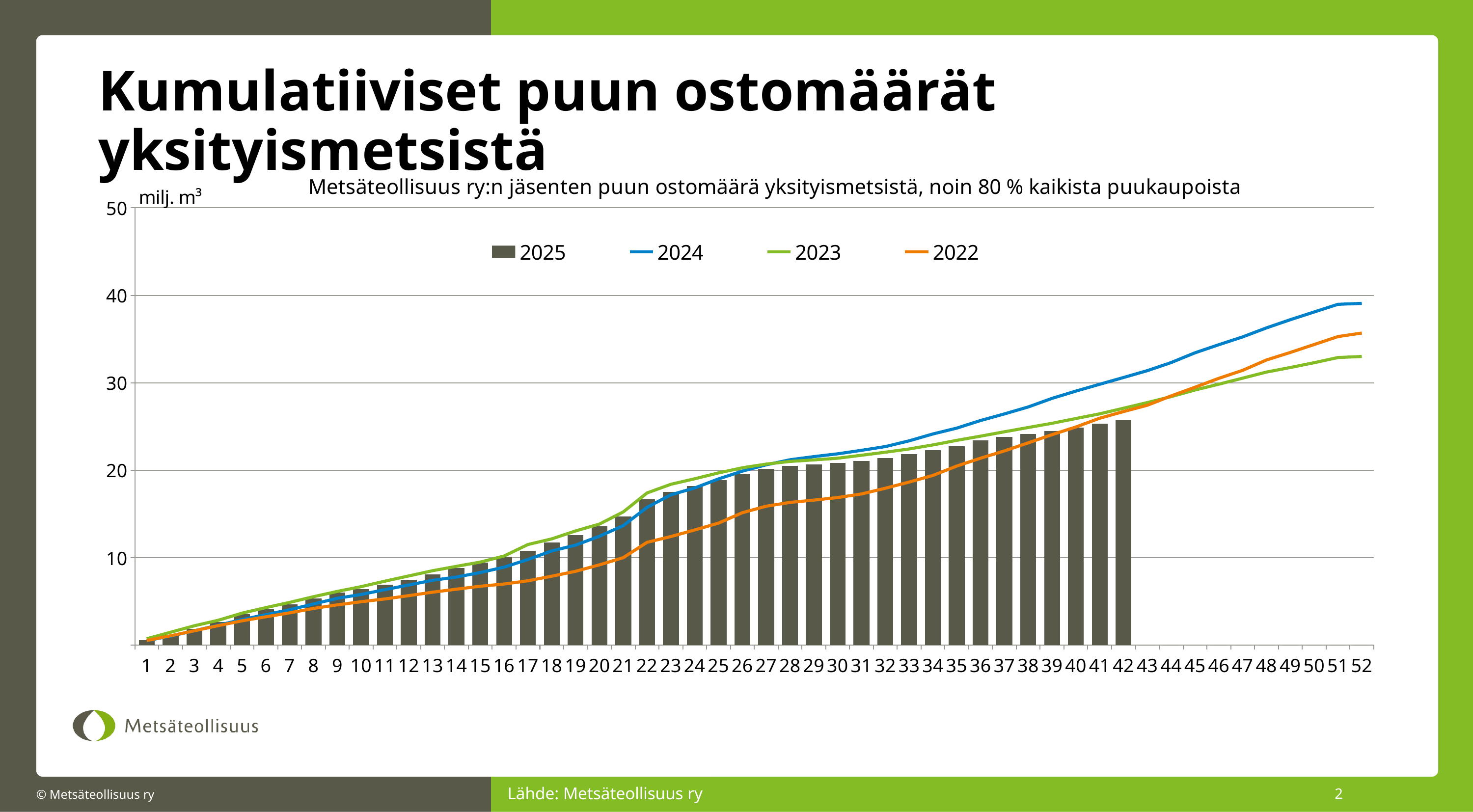
How many series does the legend list? 4 What kind of chart is this? Combined bar and line chart Is the value of the 2024 line at week 52 greater or less than 40? less Is the value of the 2023 line at week 52 greater or less than 30? greater Do the values rise or fall along the x axis? rise How many week categories are shown on the x axis? 52 Is the value of the 2025 bar at week 10 greater or less than 10? less At week 30, which is larger, the 2023 line or the 2022 line? 2023 Up to which week are bars plotted for the 2025 series? 42 At week 52, which series has the highest value? 2024